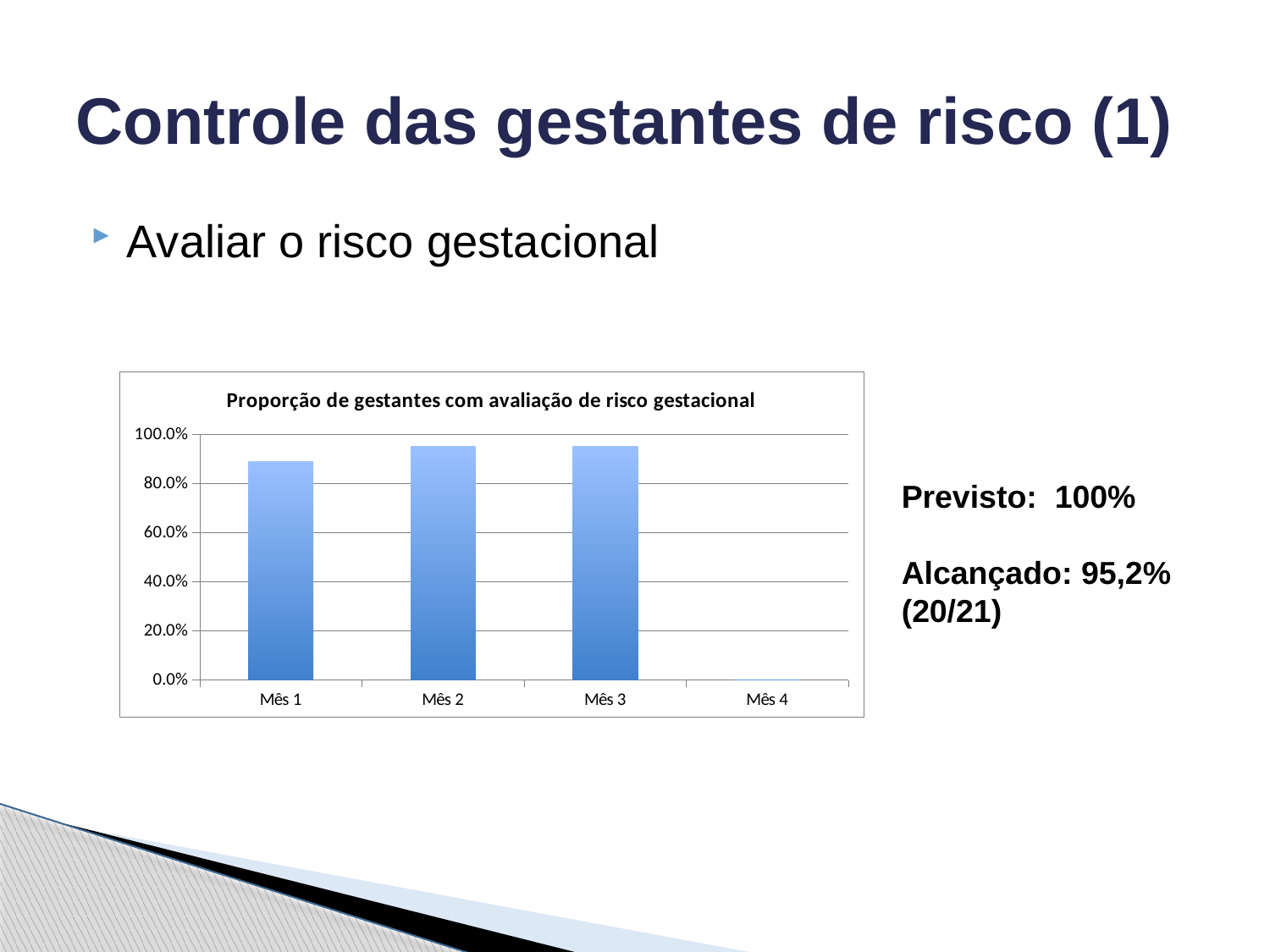
Which category on the x axis has no bar plotted? Mês 4 Among Mês 1, Mês 2 and Mês 3, which has the lowest value? Mês 1 What is the title of the chart? Proporção de gestantes com avaliação de risco gestacional Does the value rise or fall from Mês 1 to Mês 2? rise Which is larger, the value for Mês 1 or the value for Mês 3? Mês 3 How many categories are shown on the x axis of the chart? 4 What kind of chart is shown on the slide? bar chart Is the value for Mês 3 greater or less than 60.0%? greater Is the value for Mês 2 greater or less than 80.0%? greater Is the value for Mês 1 greater or less than 80.0%? greater Which is larger, the value for Mês 1 or the value for Mês 2? Mês 2